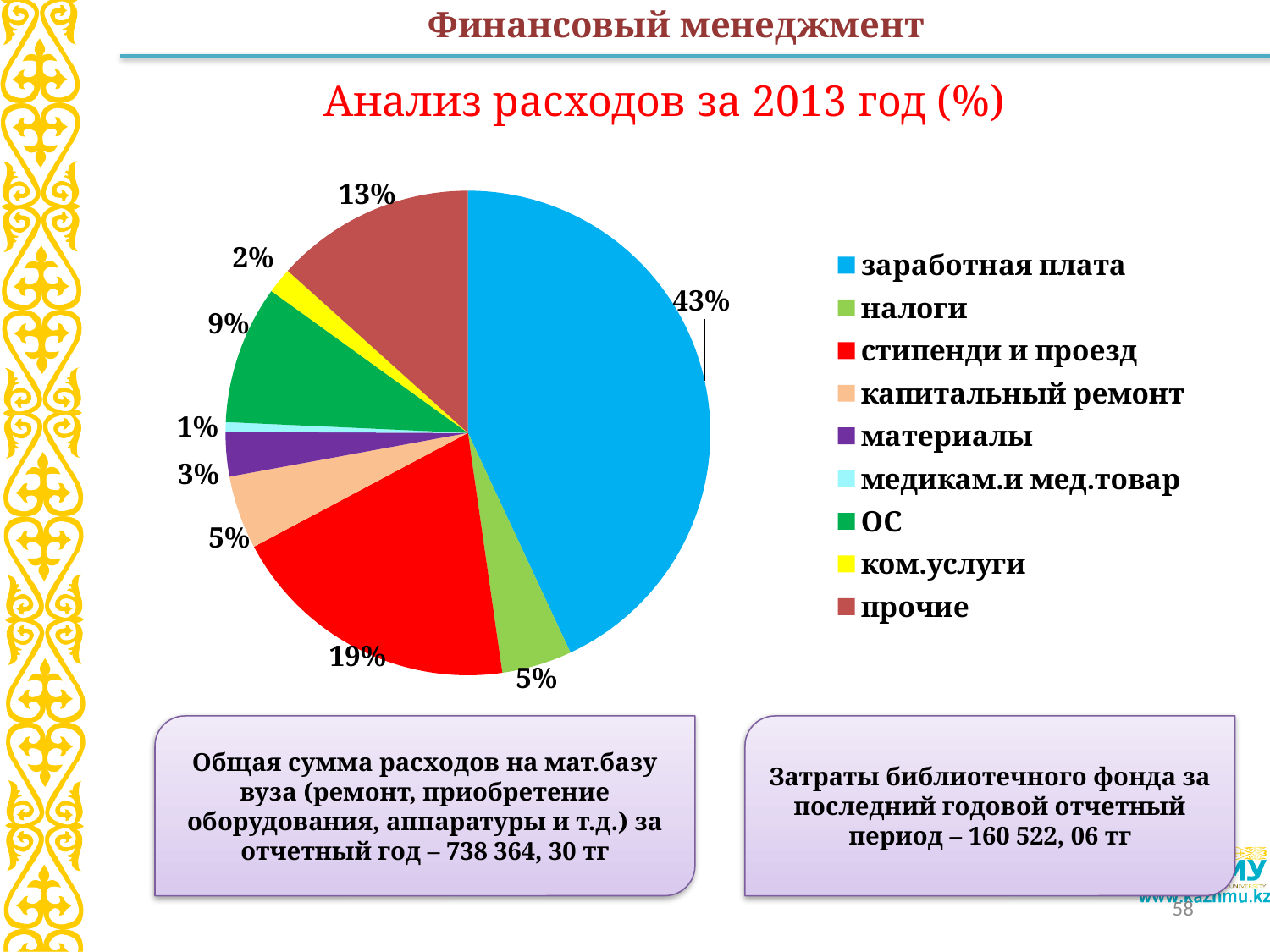
What share of expenses is прочие? 13% Which is larger, the share for ОС or the share for прочие? прочие What share of expenses is медикам.и мед.товар? 1% How many categories does the legend list? 9 What is the title of the chart? Анализ расходов за 2013 год (%) What share of expenses is ОС? 9% What type of chart is shown on the slide? pie chart What is the difference in percentage points between заработная плата and стипенди и проезд? 24 What share of expenses is стипенди и проезд? 19% Which category has the smallest share of expenses? медикам.и мед.товар Which category has the largest share of expenses? заработная плата What share of expenses is заработная плата? 43%